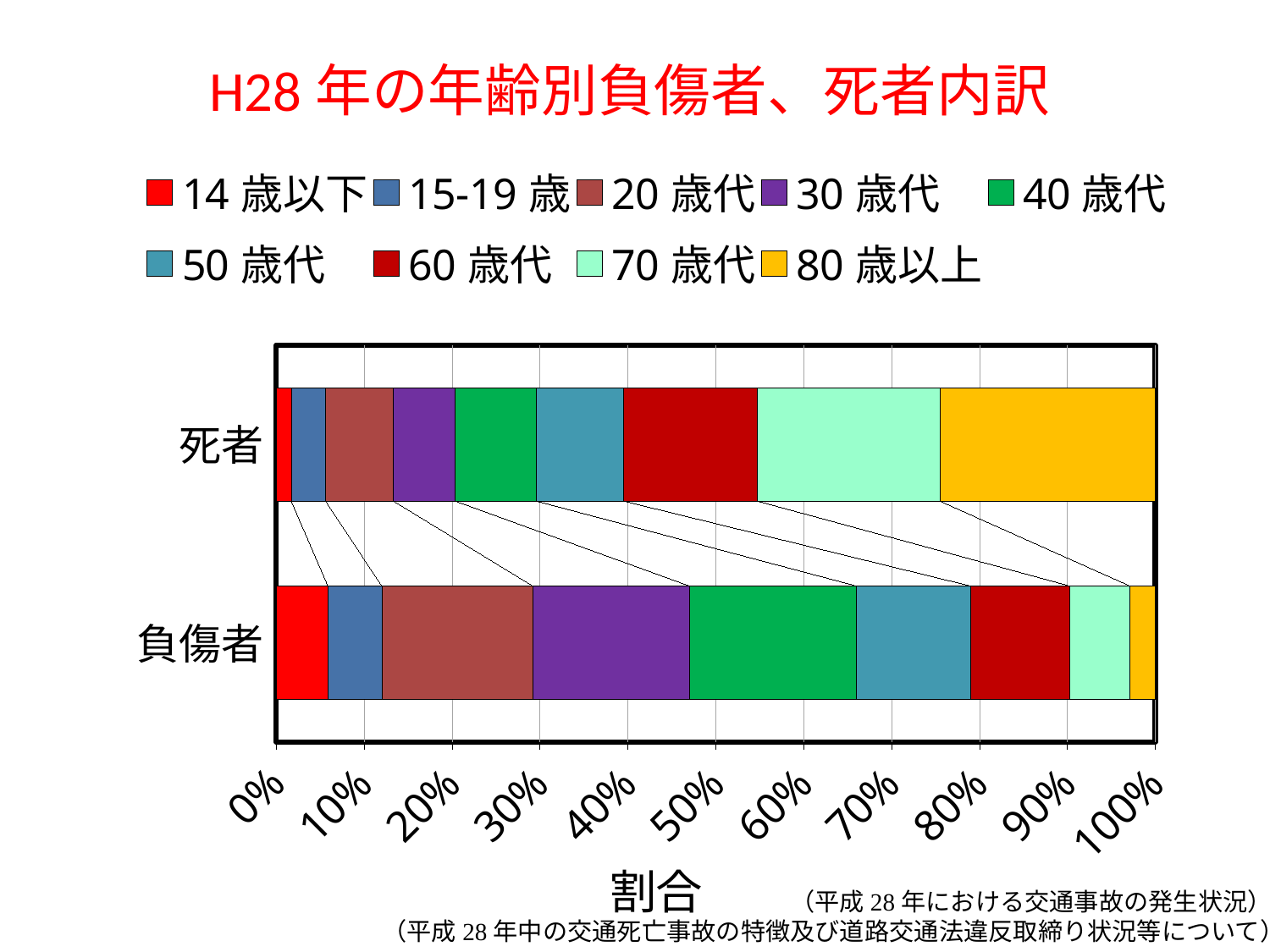
Is the 14歳以下 share of the 死者 bar greater or less than 10%? less Is the 80歳以上 share of the 死者 bar greater or less than 20%? greater How many bars (categories) does the chart show? 2 Which bar has the larger 80歳以上 share, 死者 or 負傷者? 死者 Which bar has the larger 14歳以下 share, 死者 or 負傷者? 負傷者 What is the title of the chart on the slide? H28年の年齢別負傷者、死者内訳 Is the 20歳代 share of the 負傷者 bar greater or less than 10%? greater What kind of chart is shown on the slide? stacked bar chart Which age group has the smallest share in the 死者 bar? 14歳以下 What is the label of the horizontal axis? 割合 How many series does the legend list? 9